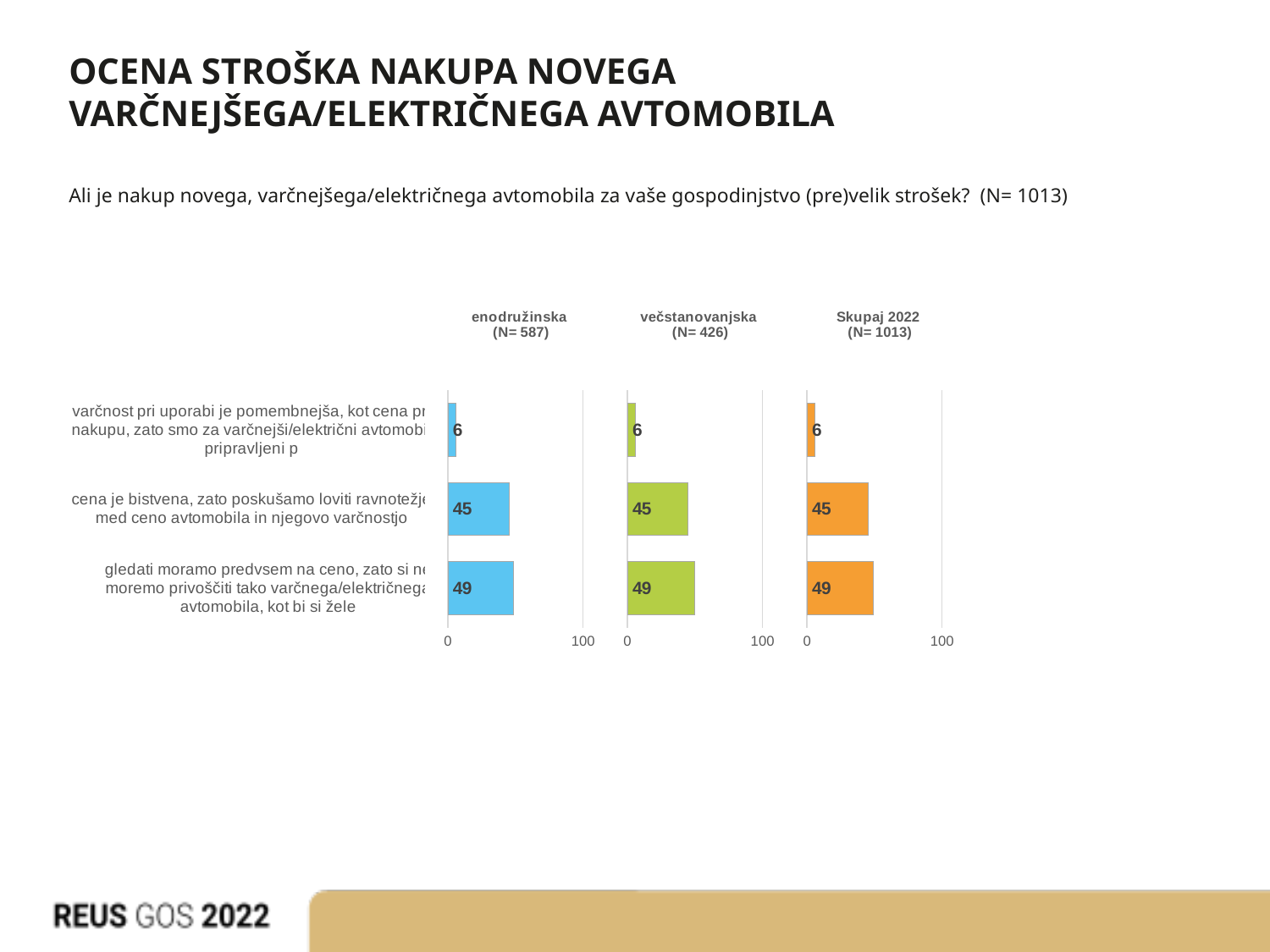
In the 'Skupaj 2022 (N= 1013)' chart, which is larger: the value for 'cena je bistvena' or the value for 'varčnost pri uporabi je pomembnejša'? cena je bistvena In the 'enodružinska (N= 587)' chart, which category has the lowest value? varčnost pri uporabi je pomembnejša, kot cena pri nakupu What kind of chart is the 'Skupaj 2022 (N= 1013)' chart? bar chart How many separate charts (panels) are shown on the slide? 3 What colour are the bars in the 'Skupaj 2022 (N= 1013)' chart? orange In the 'enodružinska (N= 587)' chart, what is the difference between the value for 'gledati moramo predvsem na ceno' and the value for 'varčnost pri uporabi je pomembnejša'? 43 In the 'enodružinska (N= 587)' chart, what is the value for 'gledati moramo predvsem na ceno, zato si ne moremo privoščiti tako varčnega/električnega avtomobila, kot bi si žele'? 49 How many categories are shown in the 'enodružinska (N= 587)' chart? 3 In the 'Skupaj 2022 (N= 1013)' chart, which category has the highest value? gledati moramo predvsem na ceno, zato si ne moremo privoščiti tako varčnega/električnega avtomobila, kot bi si žele In the 'večstanovanjska (N= 426)' chart, what is the difference between the value for 'gledati moramo predvsem na ceno' and the value for 'cena je bistvena'? 4 In the 'večstanovanjska (N= 426)' chart, what is the value for 'varčnost pri uporabi je pomembnejša, kot cena pri nakupu'? 6 In the 'Skupaj 2022 (N= 1013)' chart, what is the value for 'cena je bistvena, zato poskušamo loviti ravnotežje med ceno avtomobila in njegovo varčnostjo'? 45